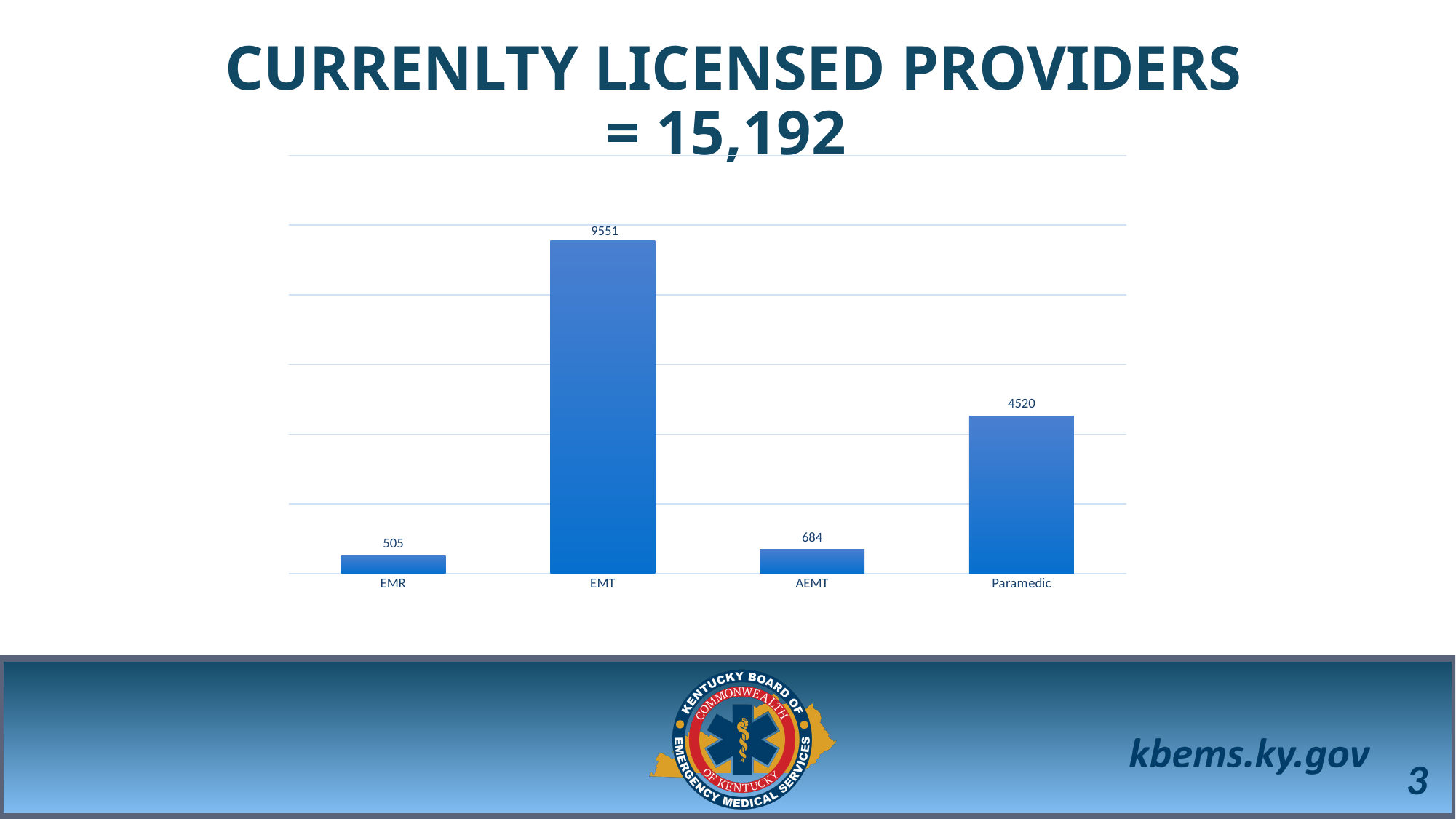
What total number of licensed providers is stated in the slide title? 15,192 Which category has the highest value? EMT What is the value for EMR? 505 What is the value for EMT? 9551 What kind of chart is shown on the slide? bar chart How many categories are shown on the x axis? 4 What is the value for AEMT? 684 What is the difference between the values for EMT and Paramedic? 5031 Which is larger, the value for AEMT or the value for EMR? AEMT Which category has the lowest value? EMR What is the difference between the values for AEMT and EMR? 179 What is the value for Paramedic? 4520